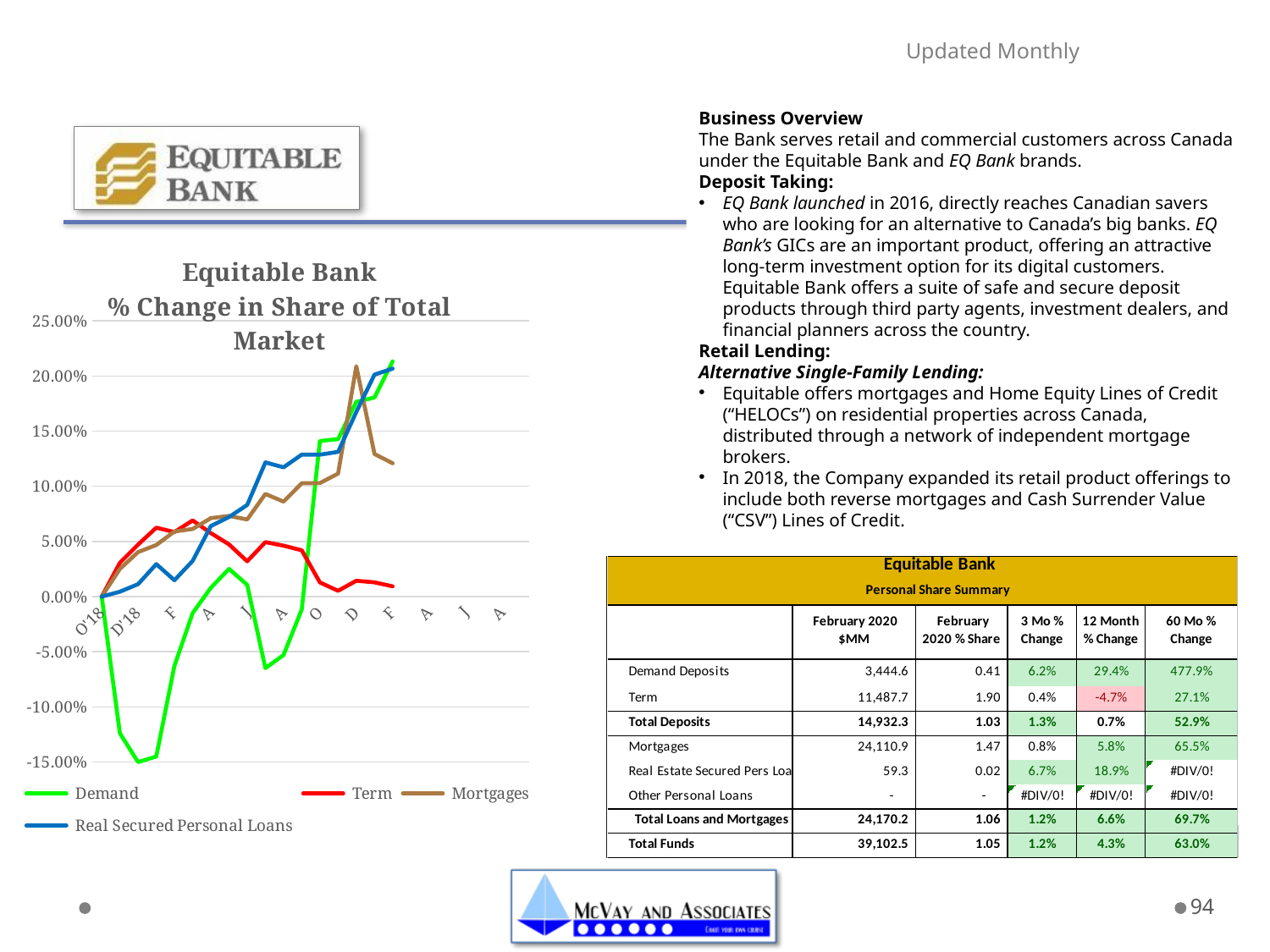
Which series is drawn in green on the chart? Demand Is the final value of the Real Secured Personal Loans series greater or less than 15.00%? greater Is the final value of the Term series greater or less than 5.00%? less Over the right-hand half of the chart, does the Term series rise or fall? fall At the last plotted point, which is larger: Demand or Term? Demand Is the highest value of the Mortgages series greater or less than 15.00%? greater What kind of chart is shown on the slide? Line chart At the last plotted point, which is larger: Mortgages or Term? Mortgages How many series does the chart's legend list? 4 Which series reaches the lowest value on the chart? Demand What is the title of the chart? Equitable Bank % Change in Share of Total Market